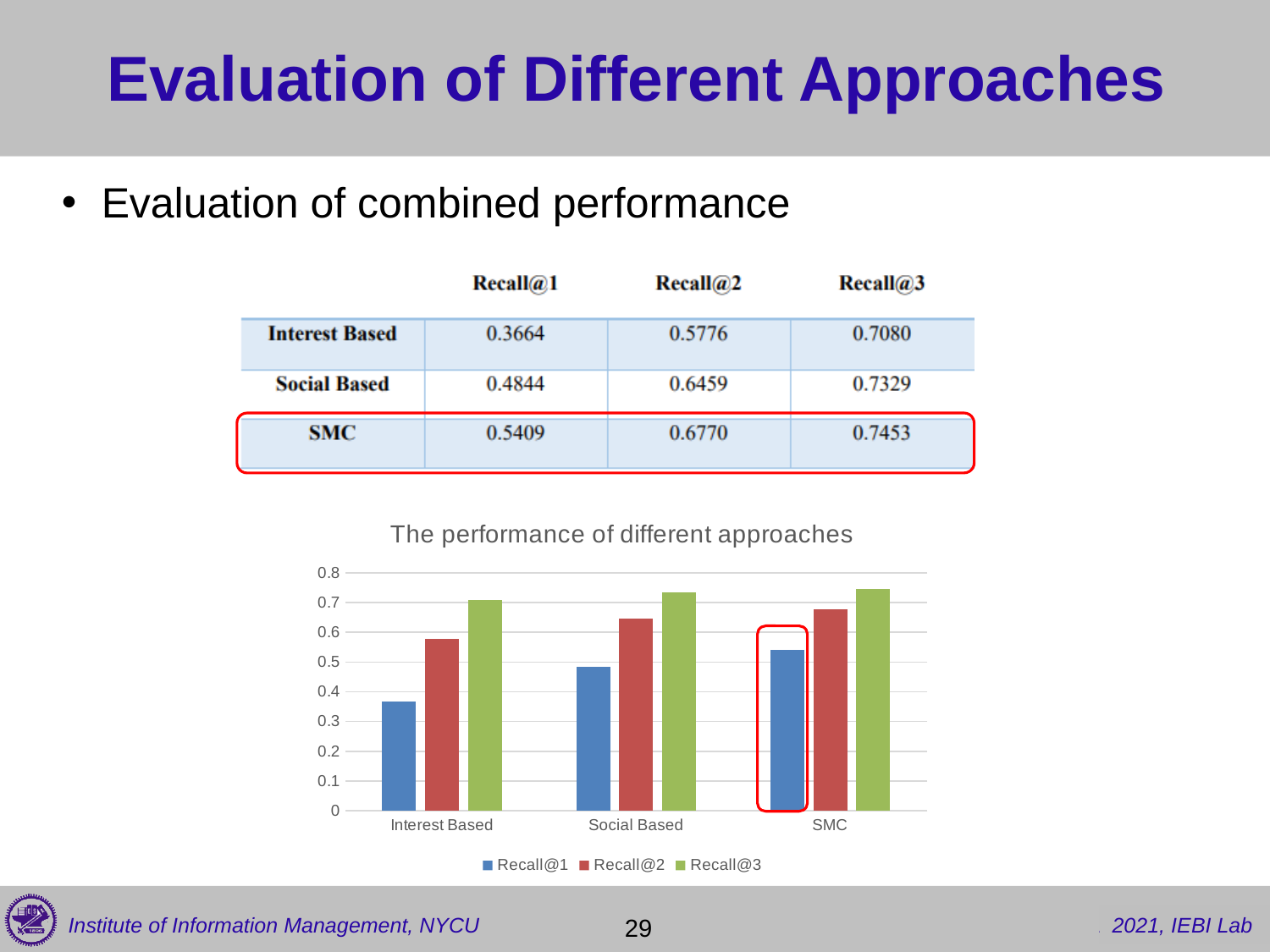
Do the Recall@1 values rise or fall from Interest Based to SMC along the x axis? rise What is the difference between the Recall@3 values of SMC and Interest Based? 0.0373 How many series does the chart legend list? 3 Which approach has the lowest Recall@3 value in the chart? Interest Based What kind of chart is shown on the slide? bar chart What is the Recall@1 value for SMC? 0.5409 Which is larger, the Recall@2 value for Social Based or the Recall@2 value for Interest Based? Social Based Which approach has the highest Recall@1 value in the chart? SMC Is the Recall@3 value for SMC greater or less than 0.7? greater Is the Recall@1 value for Interest Based greater or less than 0.4? less How many categories are shown on the x axis of the chart? 3 What is the title of the chart? The performance of different approaches